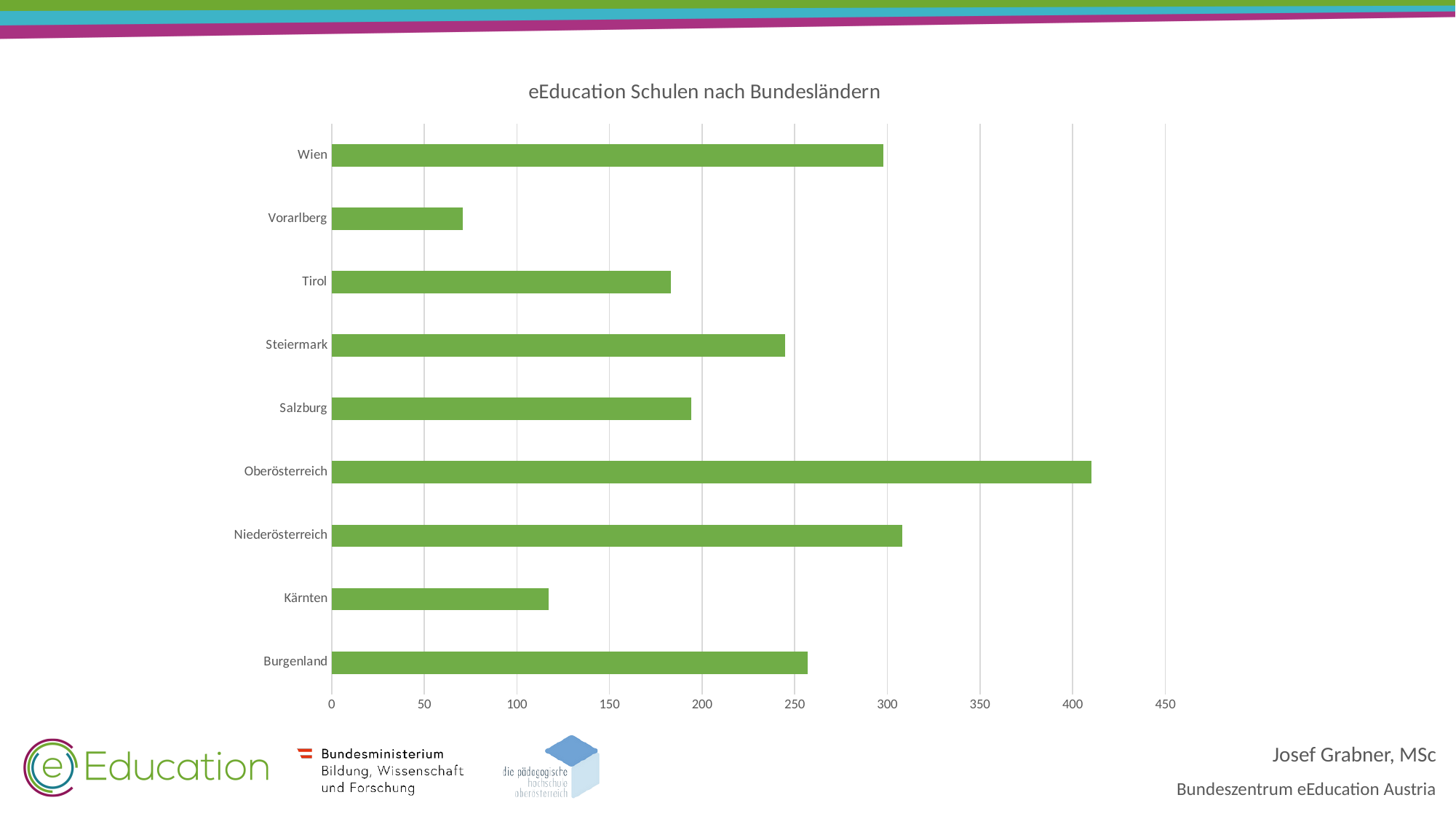
Which Bundesland has the lowest value in the chart? Vorarlberg Is the value for Steiermark greater or less than 200? greater Is the value for Vorarlberg greater or less than 50? greater What is the title of the chart? eEducation Schulen nach Bundesländern Is the value for Oberösterreich greater or less than 400? greater How many Bundesländer (categories) are shown in the chart? 9 Which has a larger value, Wien or Steiermark? Wien What kind of chart is shown on the slide? bar chart Which Bundesland has the highest value in the chart? Oberösterreich Which has a larger value, Kärnten or Tirol? Tirol